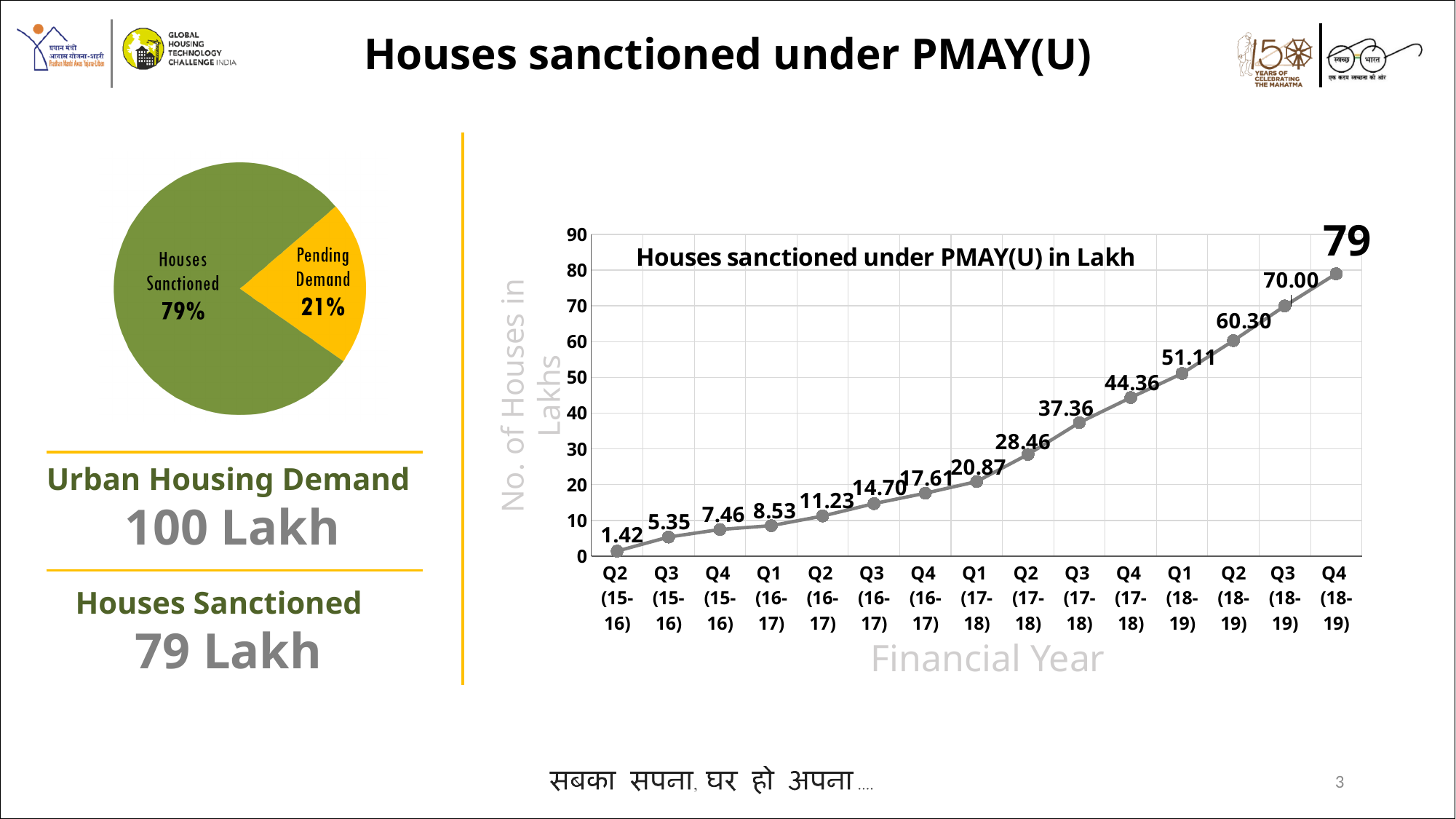
What kind of chart is the chart on the left side of the slide? pie chart In the pie chart on the left, what share is labelled 'Pending Demand'? 21% In the line chart 'Houses sanctioned under PMAY(U) in Lakh', what is the value for Q3 (18-19)? 70.00 In the line chart 'Houses sanctioned under PMAY(U) in Lakh', which quarter has the highest value? Q4 (18-19) In the line chart 'Houses sanctioned under PMAY(U) in Lakh', which is larger, the value for Q3 (16-17) or the value for Q1 (17-18)? Q1 (17-18) In the line chart 'Houses sanctioned under PMAY(U) in Lakh', do the values rise or fall from Q2 (15-16) to Q4 (18-19)? rise In the line chart 'Houses sanctioned under PMAY(U) in Lakh', how many quarters are plotted on the x axis? 15 In the line chart 'Houses sanctioned under PMAY(U) in Lakh', what is the value for Q2 (17-18)? 28.46 In the line chart 'Houses sanctioned under PMAY(U) in Lakh', what is the value for Q2 (15-16)? 1.42 What kind of chart is the chart on the right side of the slide? line chart In the line chart 'Houses sanctioned under PMAY(U) in Lakh', what is the difference between the values for Q1 (18-19) and Q4 (17-18)? 6.75 In the line chart 'Houses sanctioned under PMAY(U) in Lakh', which quarter has the lowest value? Q2 (15-16)